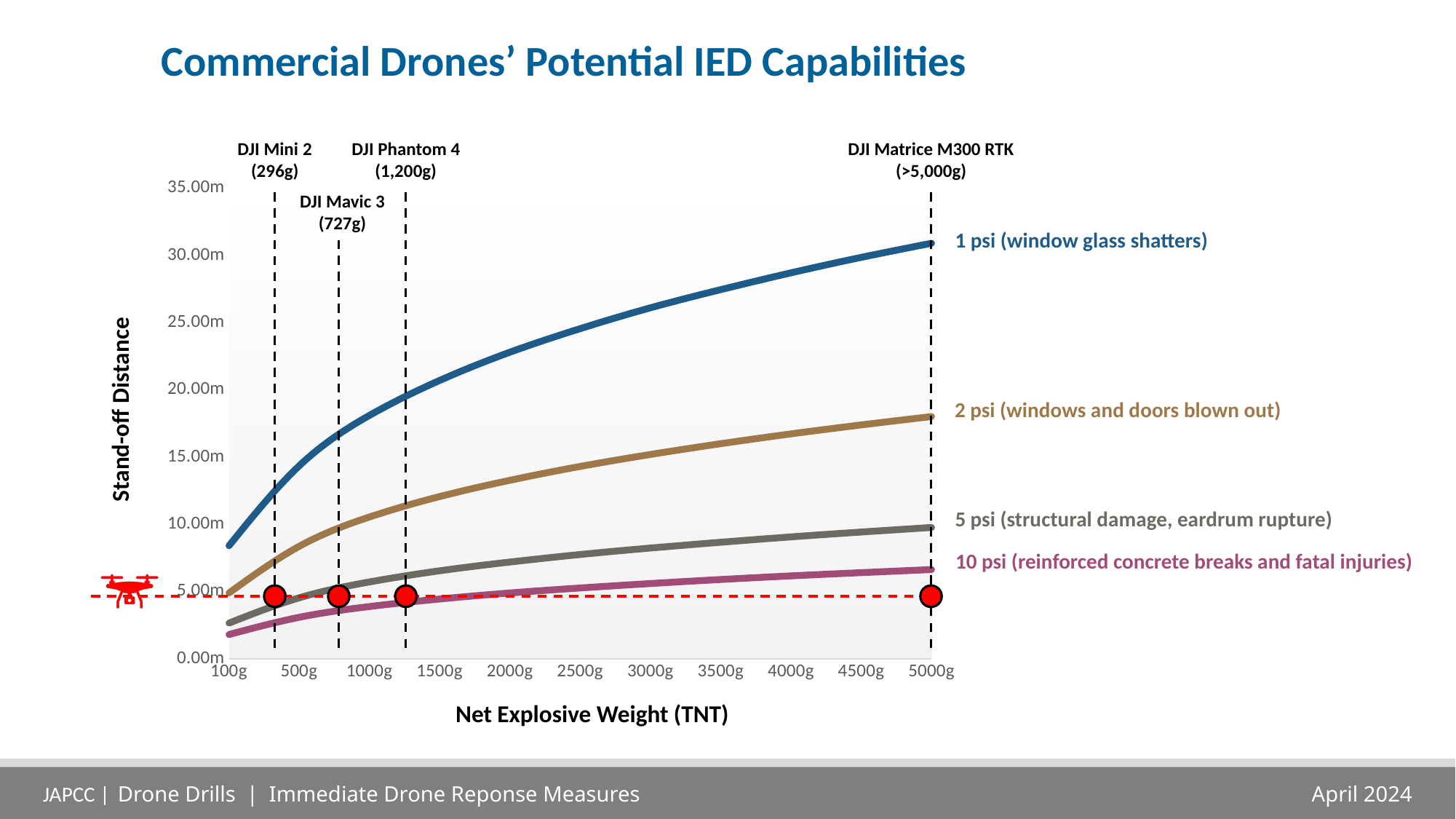
Is the stand-off distance for the 1 psi line at 5000g greater or less than 25.00m? greater At 5000g, which line shows a larger stand-off distance: 1 psi or 2 psi? 1 psi Is the stand-off distance for the 10 psi line at 5000g greater or less than 10.00m? less What kind of chart is shown on the slide? Line chart What explosive weight is annotated for the DJI Phantom 4 on the chart? 1,200g Is the stand-off distance for the 1 psi line at 100g greater or less than 10.00m? less What is the title of the x axis? Net Explosive Weight (TNT) How many psi overpressure series (lines) are plotted on the chart? 4 Which series has the highest stand-off distance across the chart? 1 psi (window glass shatters) Do the stand-off distances rise or fall as net explosive weight increases along the x axis? Rise Which series has the lowest stand-off distance across the chart? 10 psi (reinforced concrete breaks and fatal injuries)